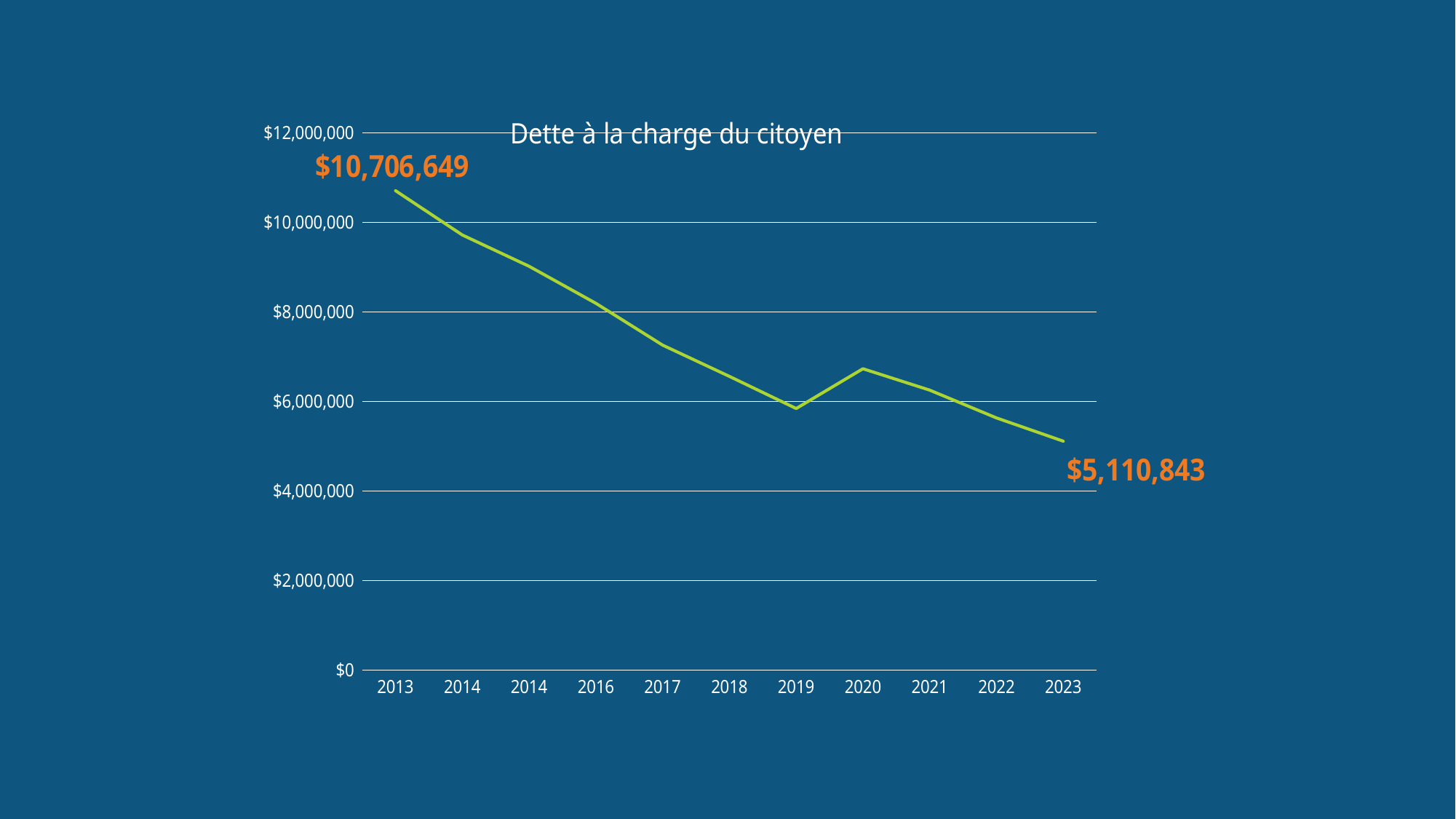
Which is larger, the value for 2019 or the value for 2020? 2020 What is the value for 2023? $5,110,843 Is the value for 2020 greater or less than $6,000,000? greater What is the difference between the 2013 value and the 2023 value? $5,595,806 What is the title of the chart? Dette à la charge du citoyen Which year has the highest value? 2013 How many data points are plotted on the line? 11 Which year has the lowest value? 2023 What is the value for 2013? $10,706,649 Is the value for 2017 greater or less than $8,000,000? less Do the values generally rise or fall from 2013 to 2023? Fall What kind of chart is shown on the slide? Line chart